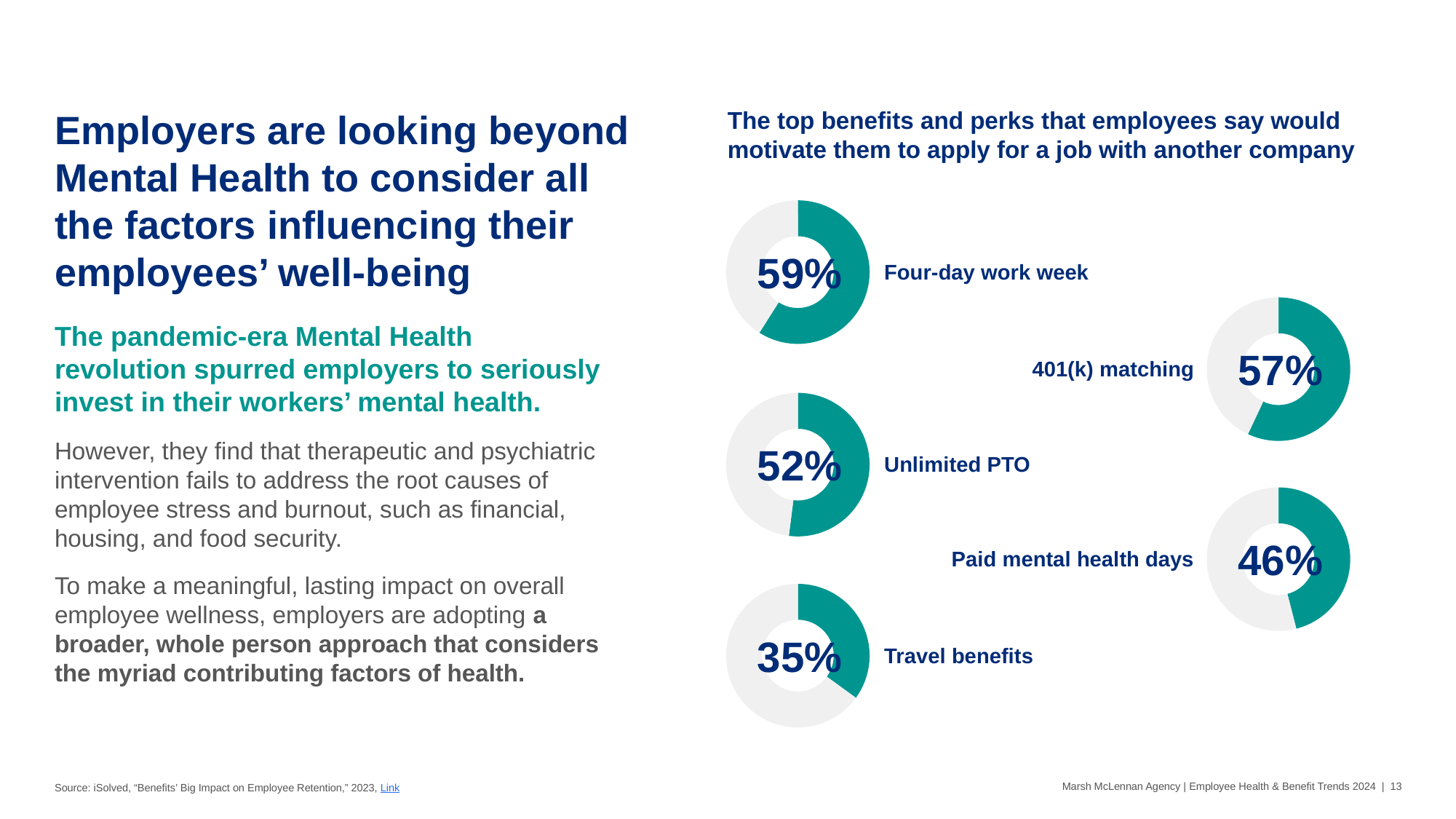
What value is shown for Paid mental health days? 46% What percentage is shown for Travel benefits? 35% What value is shown for 401(k) matching? 57% Which has a higher percentage, 401(k) matching or Paid mental health days? 401(k) matching Which benefit or perk has the lowest percentage on the slide? Travel benefits What percentage of employees say a four-day work week would motivate them to apply for a job with another company? 59% How many benefits or perks are shown with donut charts on the slide? 5 What is the difference in percentage points between Four-day work week and Travel benefits? 24 What percentage is shown for Unlimited PTO? 52% Which benefit or perk has the highest percentage on the slide? Four-day work week What kind of chart is used to show each percentage on the slide? Donut chart What is the difference in percentage points between Unlimited PTO and Paid mental health days? 6